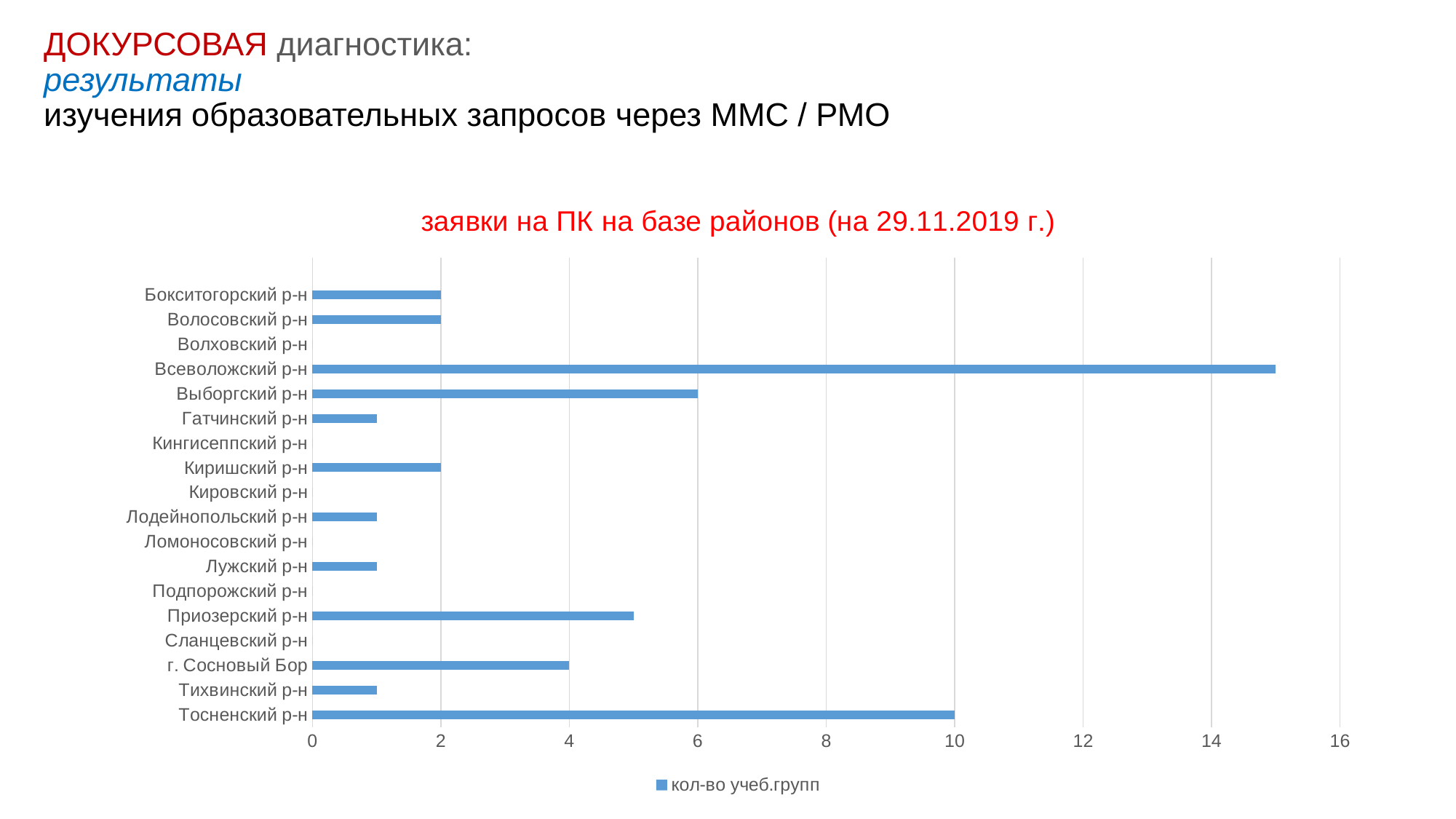
What is the value for г. Сосновый Бор? 4 Is the value for Приозерский р-н greater or less than 4? greater Which is larger, the value for Тосненский р-н or the value for г. Сосновый Бор? Тосненский р-н What is the value for Выборгский р-н? 6 What is the value for Киришский р-н? 2 What is the value for Тосненский р-н? 10 Which district has the highest value in the chart? Всеволожский р-н What type of chart is shown on the slide? bar chart What is the difference between the values for Тосненский р-н and Выборгский р-н? 4 Is the value for Гатчинский р-н greater or less than 2? less Is the value for Всеволожский р-н greater or less than 14? greater How many districts (categories) are listed on the chart's vertical axis? 18